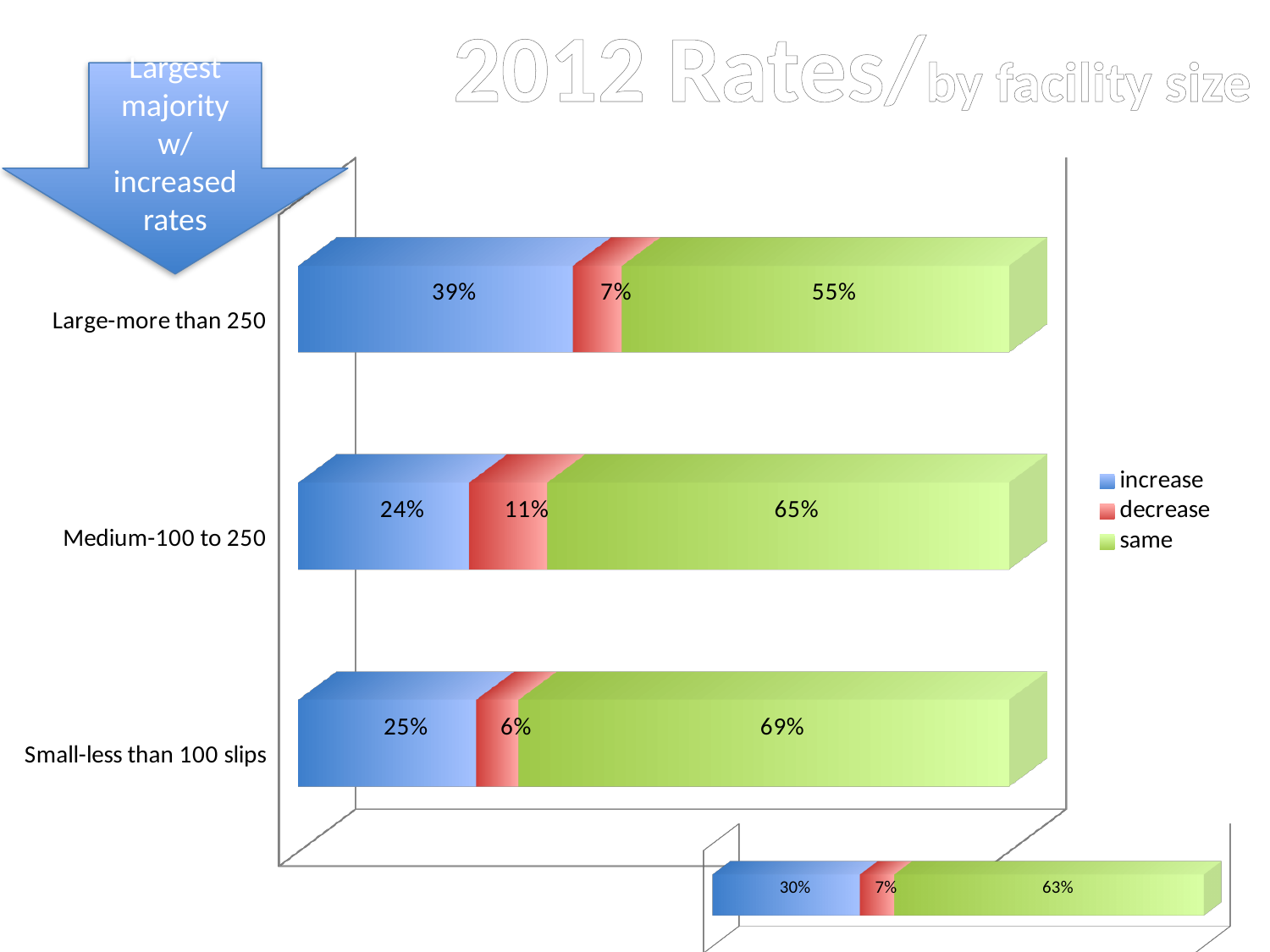
In the large chart, how many series does the legend list? 3 In the large chart, how many facility size categories are shown? 3 In the large chart, which category has the lowest 'same' value? Large-more than 250 In the small chart at the bottom right of the slide, what value is printed on the green segment? 63% In the large chart, what is the difference between the 'same' values for Small-less than 100 slips and Large-more than 250? 14% In the large chart, what is the 'decrease' value for Small-less than 100 slips? 6% In the large chart, which series is shown in green? same In the large chart, is the 'decrease' value larger for Medium-100 to 250 or for Large-more than 250? Medium-100 to 250 In the large chart, what is the 'increase' value for Large-more than 250? 39% In the large chart, which category has the highest 'increase' value? Large-more than 250 In the large chart, what is the 'same' value for Medium-100 to 250? 65% What kind of chart is the large chart on the slide? Stacked bar chart